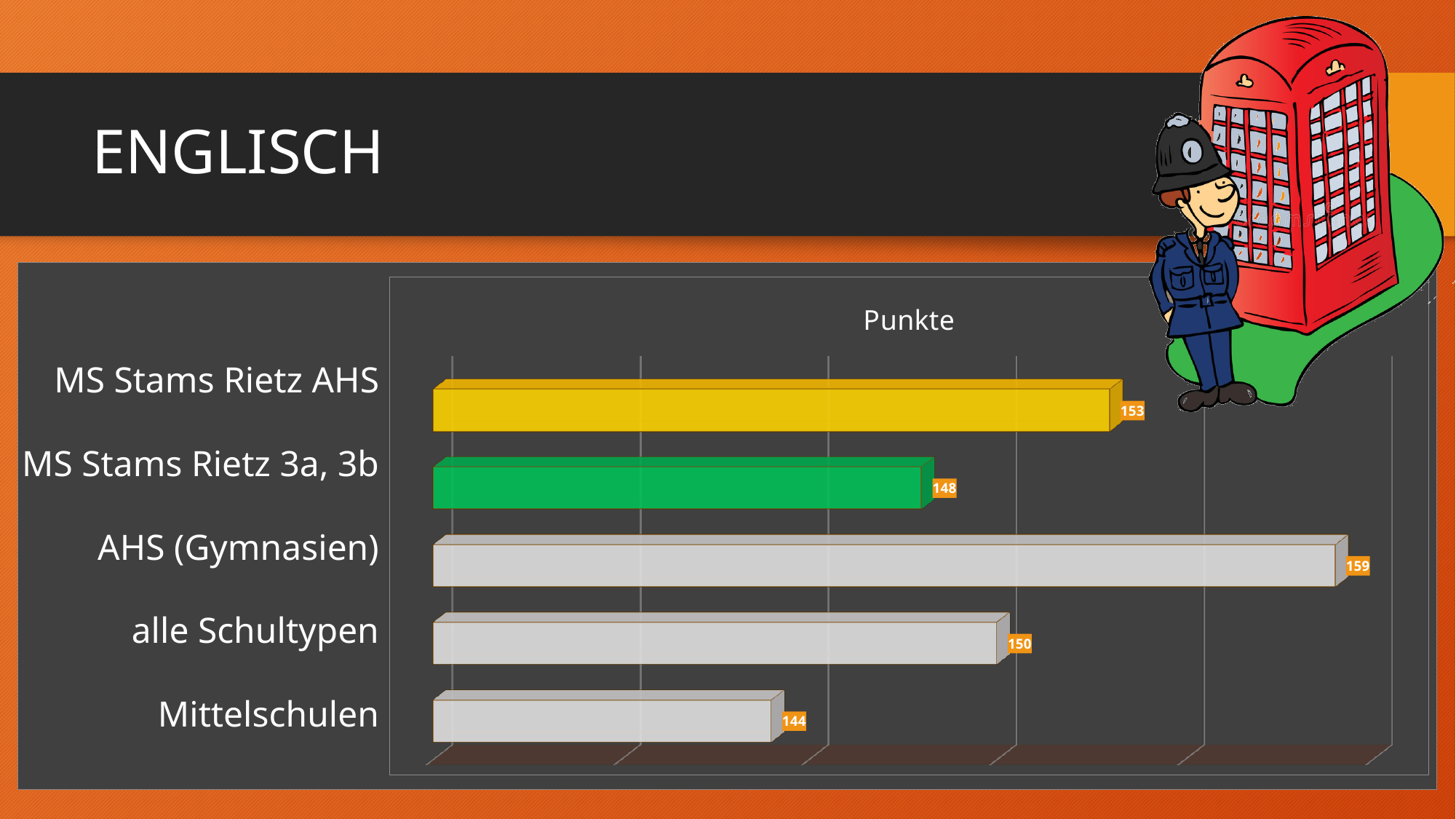
What is the value for AHS (Gymnasien)? 159 What is the title of the chart? Punkte What kind of chart is shown on the slide? bar chart Which category has the lowest value? Mittelschulen Which category has the highest value? AHS (Gymnasien) What is the difference between the values for AHS (Gymnasien) and Mittelschulen? 15 What is the value for MS Stams Rietz 3a, 3b? 148 What is the value for Mittelschulen? 144 Which is larger, the value for alle Schultypen or the value for MS Stams Rietz 3a, 3b? alle Schultypen What is the value for MS Stams Rietz AHS? 153 What is the difference between the values for MS Stams Rietz AHS and MS Stams Rietz 3a, 3b? 5 How many categories are shown in the chart? 5